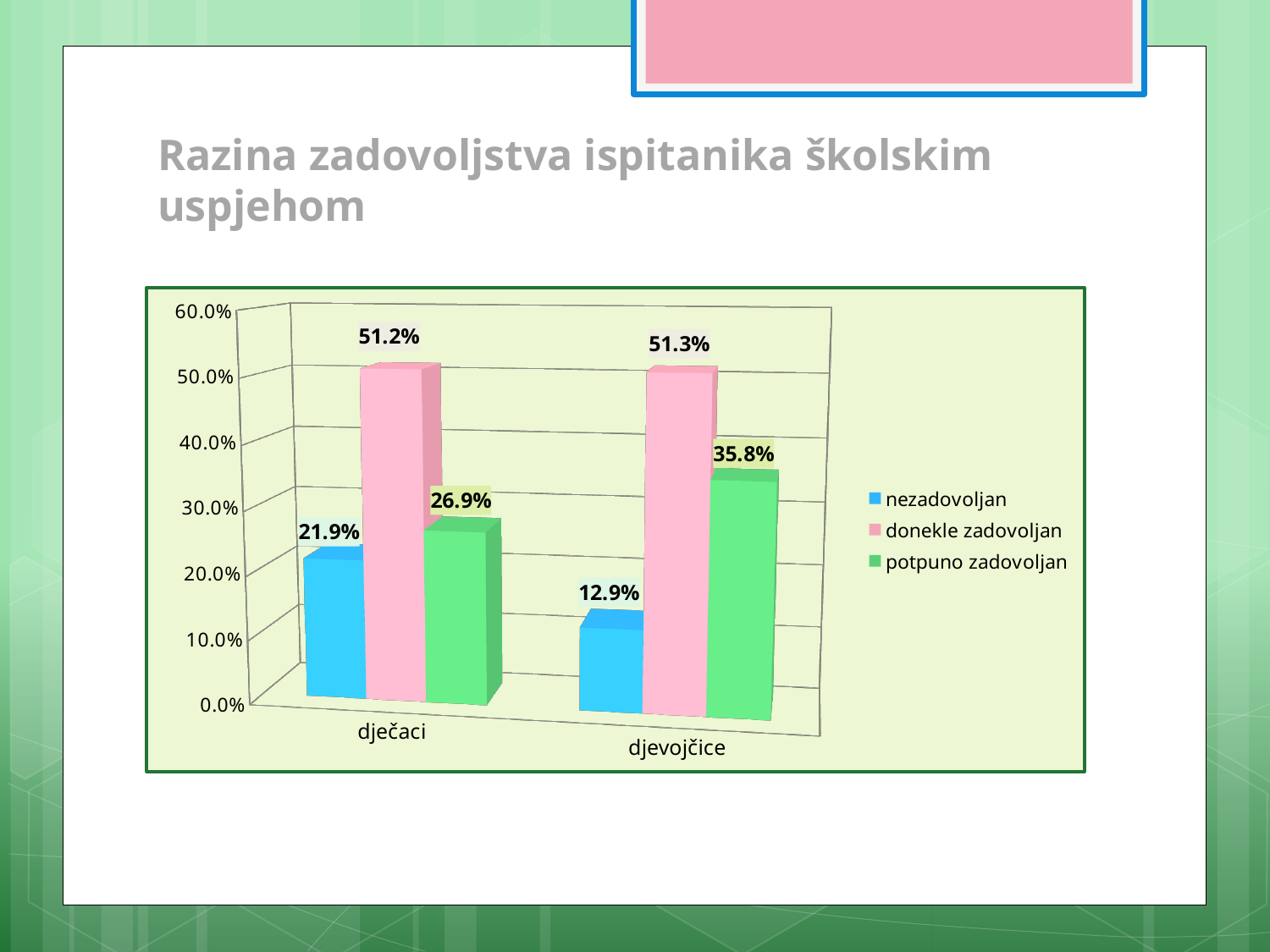
How many categories are shown on the x axis? 2 What kind of chart is shown on the slide? bar chart What is the value for nezadovoljan among dječaci? 21.9% Which is larger: the nezadovoljan value for dječaci or for djevojčice? dječaci What is the difference between the potpuno zadovoljan values for djevojčice and dječaci? 8.9% How many series does the legend list? 3 Which series has the highest value for djevojčice? donekle zadovoljan Is the potpuno zadovoljan value for djevojčice greater or less than 30.0%? greater Which series has the lowest value for dječaci? nezadovoljan What is the value for nezadovoljan among djevojčice? 12.9% What is the value for potpuno zadovoljan among dječaci? 26.9% What is the value for donekle zadovoljan among djevojčice? 51.3%